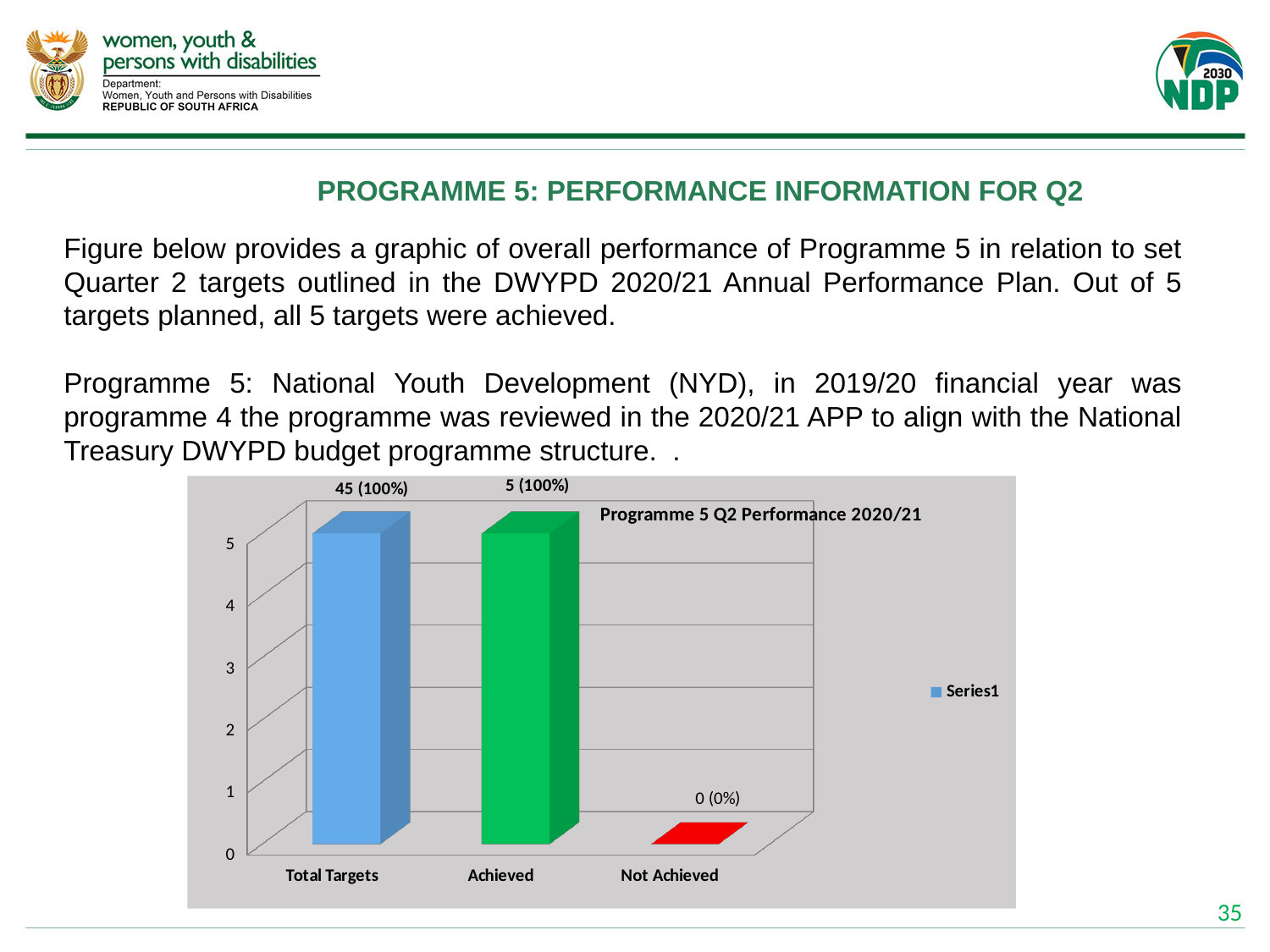
How many series does the chart legend list? 1 What type of chart is shown on the slide? bar chart What data label is printed above the Achieved bar? 5 (100%) How many categories are shown on the x axis of the chart? 3 What is the title of the chart? Programme 5 Q2 Performance 2020/21 What is the name of the series shown in the chart legend? Series1 Which is larger, the value for Achieved or the value for Not Achieved? Achieved What data label is printed above the Not Achieved bar? 0 (0%) Which category has the lowest value in the chart? Not Achieved What data label is printed above the Total Targets bar? 45 (100%) Is the value for Achieved greater or less than 3? greater Is the value for Not Achieved greater or less than 1? less